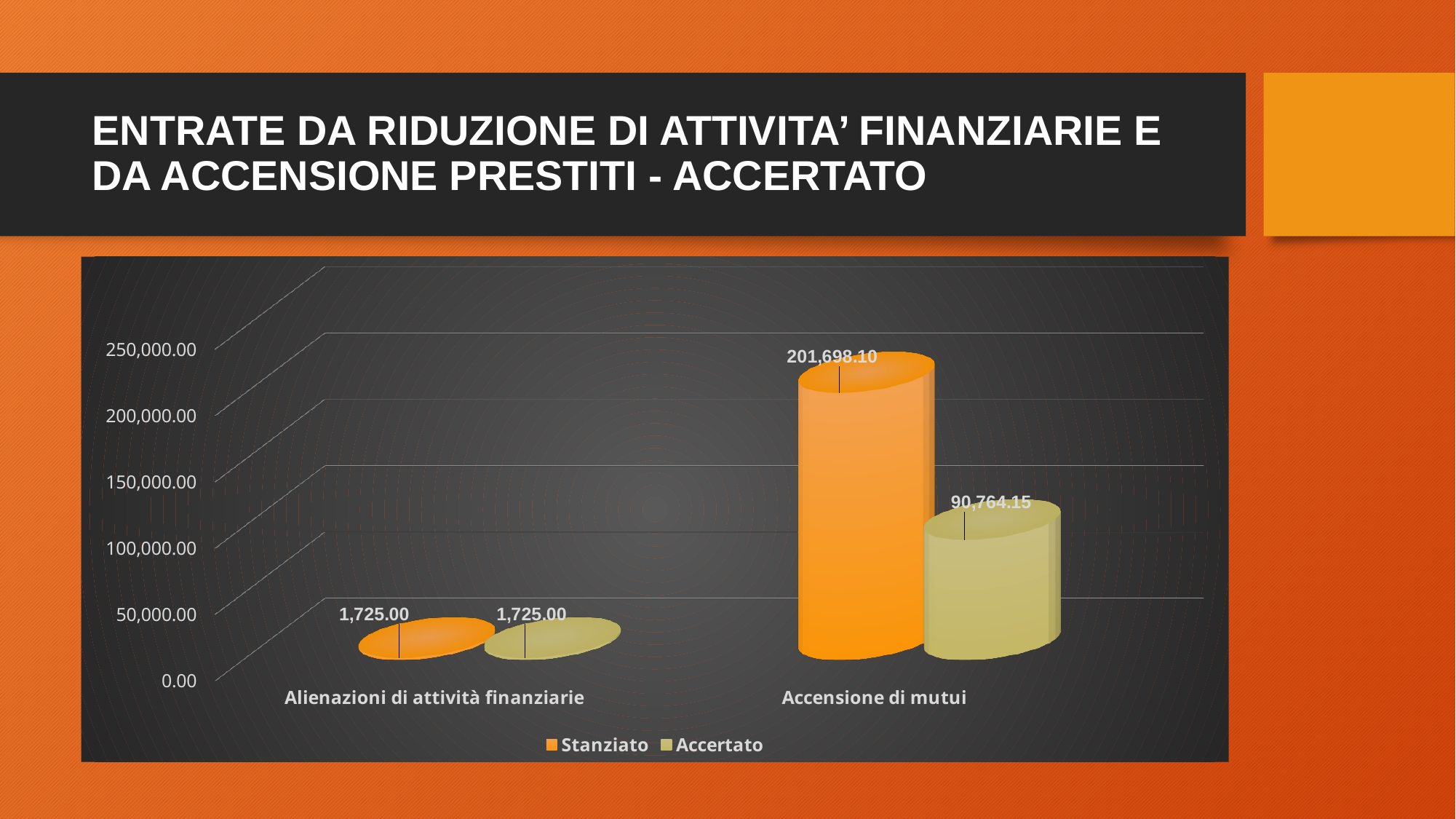
What is the Accertato value for Alienazioni di attività finanziarie? 1,725.00 How many categories are shown on the x axis? 2 For Accensione di mutui, which is larger: Stanziato or Accertato? Stanziato What is the Stanziato value for Alienazioni di attività finanziarie? 1,725.00 How many series does the legend list? 2 Which category has the lowest Accertato value? Alienazioni di attività finanziarie What is the Accertato value for Accensione di mutui? 90,764.15 What is the difference between the Stanziato and Accertato values for Accensione di mutui? 110,933.95 Is the Stanziato value for Accensione di mutui greater or less than 200,000.00? greater What is the Stanziato value for Accensione di mutui? 201,698.10 What kind of chart is shown on the slide? Bar chart Which category has the highest Stanziato value? Accensione di mutui